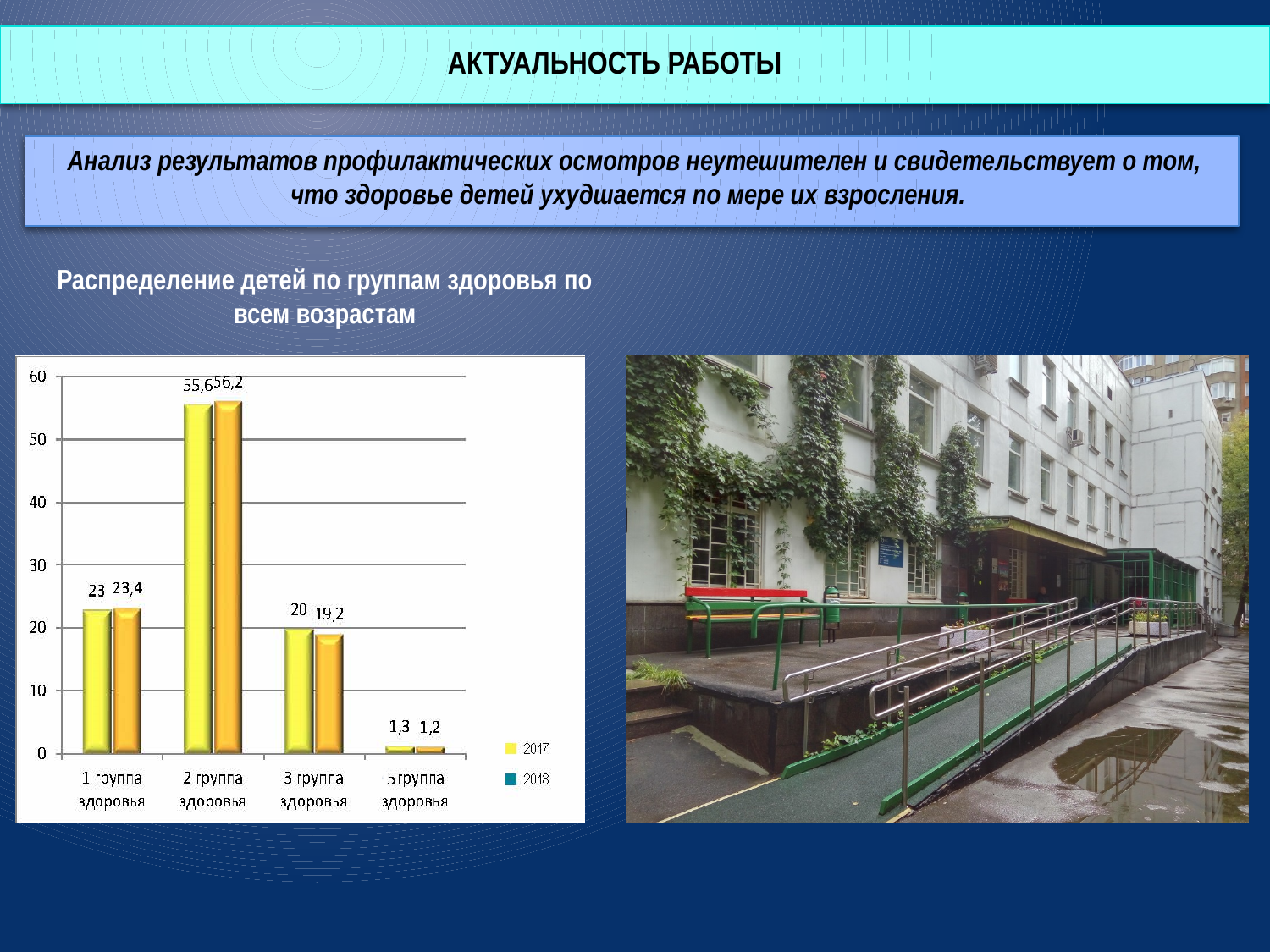
What is the value for 2 группа здоровья in the 2018 series? 56,2 What is the value for 5 группа здоровья in the 2018 series? 1,2 How many series does the chart legend list? 2 Is the value for 2 группа здоровья in 2017 greater or less than 50? greater For 3 группа здоровья, which series has the larger value, 2017 or 2018? 2017 What is the value for 1 группа здоровья in the 2017 series? 23 What kind of chart is shown on the slide? bar chart Which category has the lowest value in the 2018 series? 5 группа здоровья What is the difference between the 2018 and 2017 values for 2 группа здоровья? 0,6 Which category has the highest value in the 2017 series? 2 группа здоровья What is the value for 3 группа здоровья in the 2017 series? 20 How many categories are shown on the x axis of the chart? 4